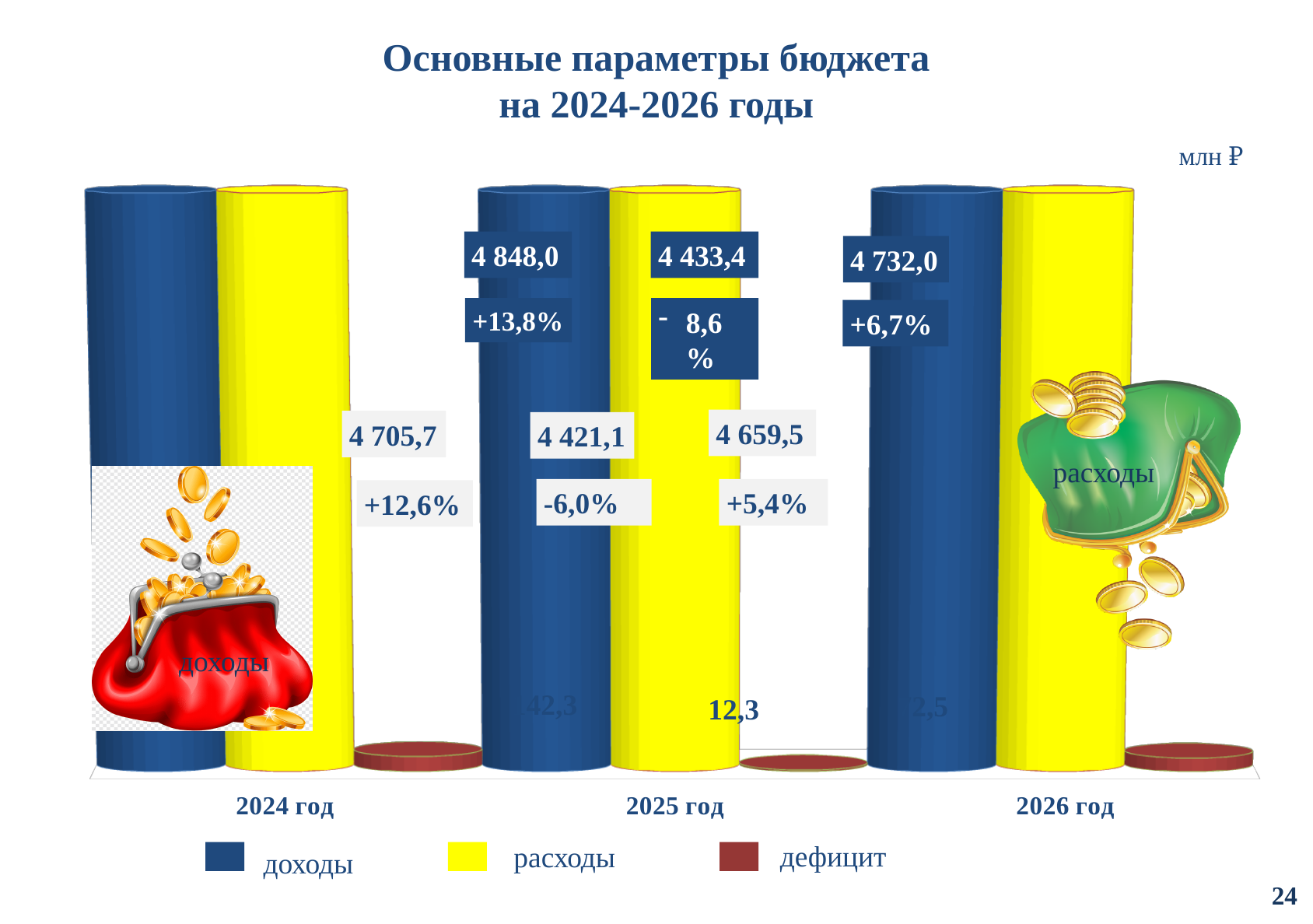
In 2025 год, which is larger, доходы or расходы? расходы What is the value of доходы for 2026 год? 4 659,5 How many years (categories) are shown on the x axis? 3 What is the value of расходы for 2026 год? 4 732,0 What percentage change is shown for доходы in 2024 год? +12,6% What are the three series listed in the legend? доходы, расходы, дефицит What is the value of дефицит for 2025 год? 12,3 How many series does the legend list? 3 What is the value of доходы for 2025 год? 4 421,1 What is the value of расходы for 2025 год? 4 433,4 What unit is indicated for the values on the chart? млн ₽ What kind of chart is shown on the slide? bar chart